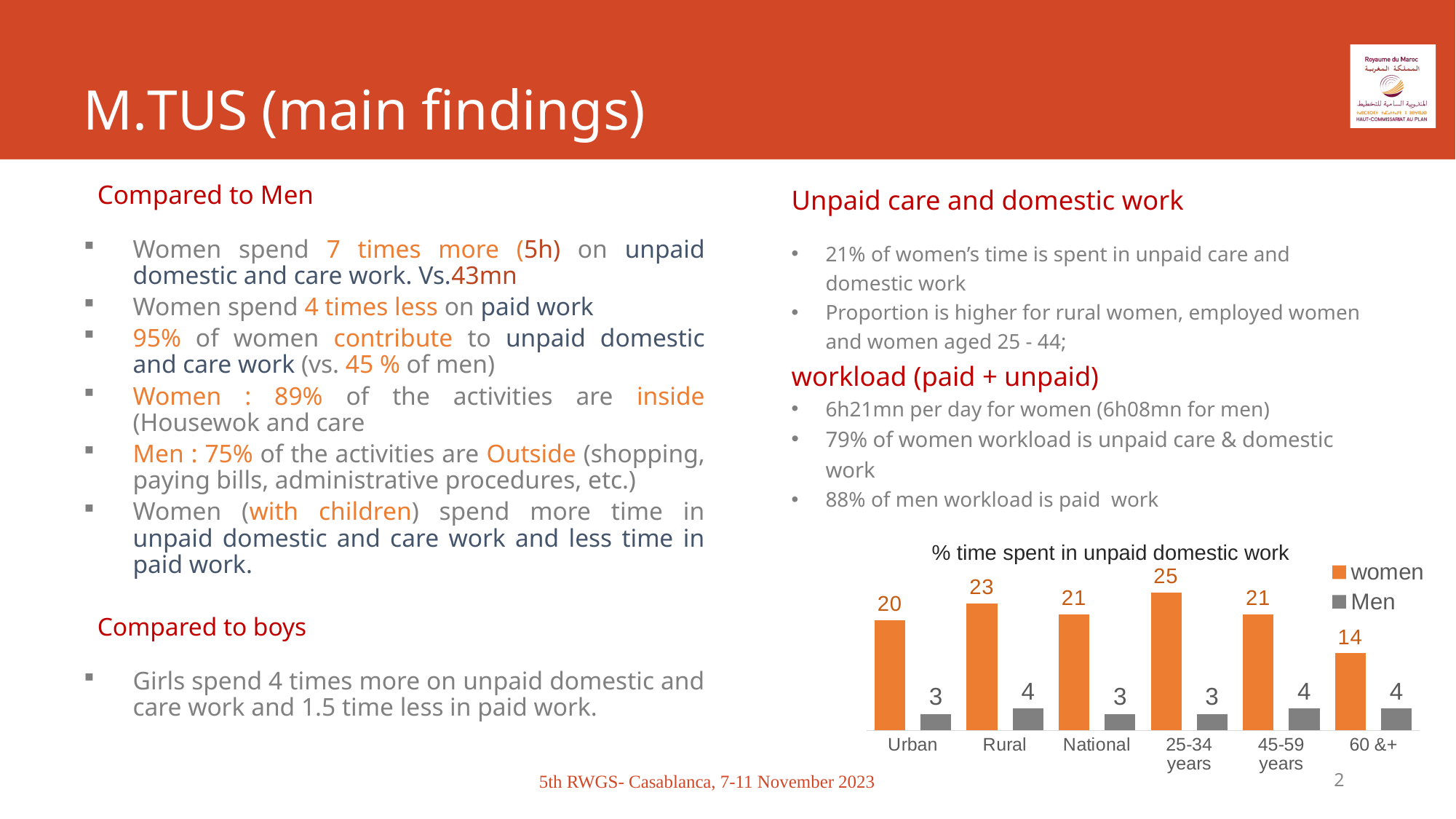
How many categories are shown on the x axis of the chart? 6 What is the difference between the women values for Rural and Urban? 3 Which is larger, the women value for Rural or the women value for Urban? Rural Which category has the highest value for women? 25-34 years What is the title of the chart? % time spent in unpaid domestic work How many series does the chart legend list? 2 What is the value for Men in the 45-59 years category? 4 What is the value for women in the Rural category? 23 What is the difference between the women and Men values in the National category? 18 What kind of chart is shown on the slide? bar chart What is the value for women in the 60 &+ category? 14 Which category has the lowest value for women? 60 &+